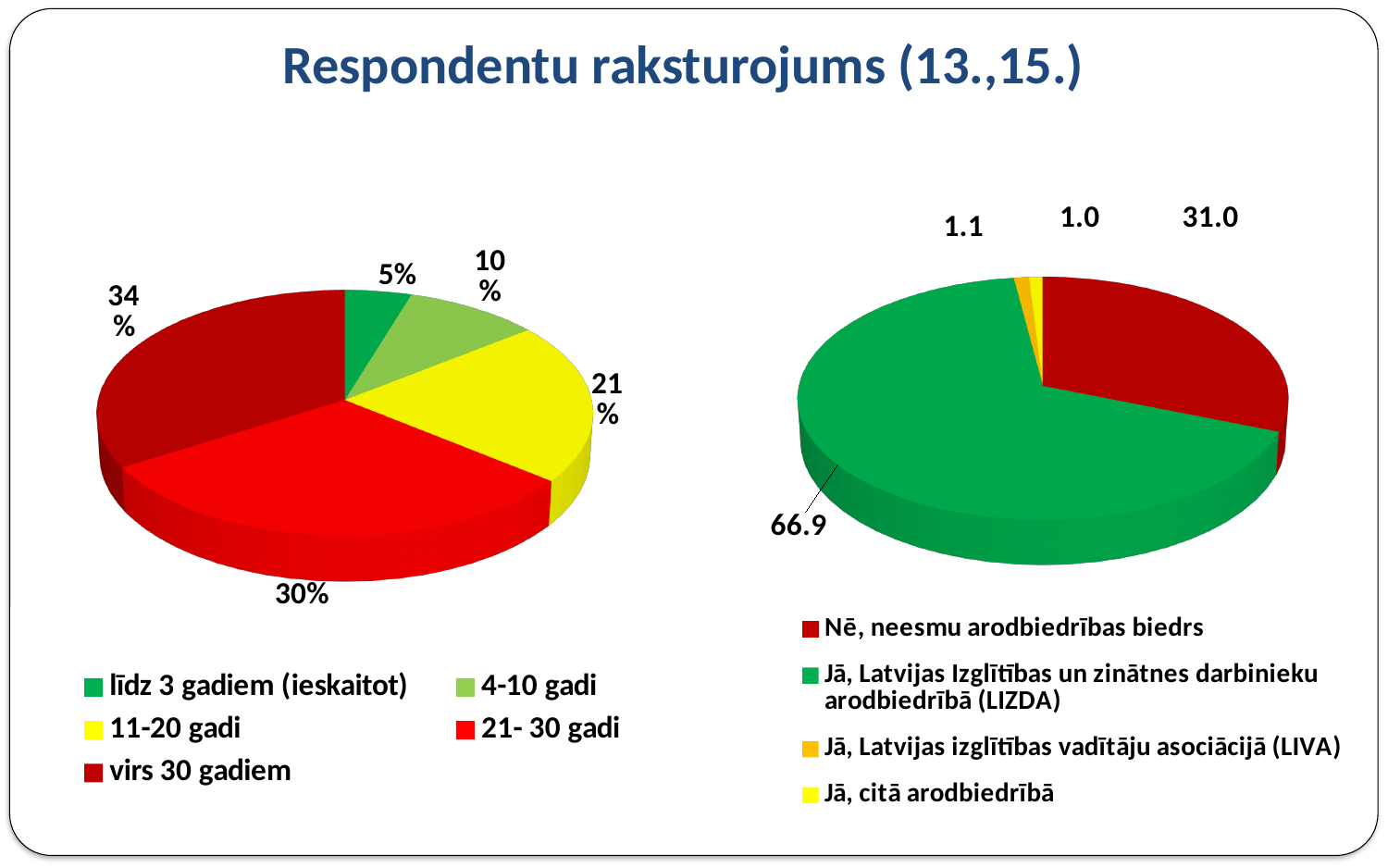
On the right pie chart, how many categories does the legend list? 4 On the left pie chart, which category has the largest share? virs 30 gadiem What type of chart is used on the left side of the slide? Pie chart On the left pie chart, what percentage of respondents have 21-30 gadi of experience? 30% On the left pie chart, which category has the smallest share? līdz 3 gadiem (ieskaitot) On the left pie chart, what is the value for 'līdz 3 gadiem (ieskaitot)'? 5% On the right pie chart, what is the value for 'Nē, neesmu arodbiedrības biedrs'? 31.0 On the left pie chart, what is the difference between the shares for '11-20 gadi' and '4-10 gadi'? 11% On the left pie chart, how many categories are shown? 5 On the right pie chart, what is the value for 'Jā, Latvijas Izglītības un zinātnes darbinieku arodbiedrībā (LIZDA)'? 66.9 On the left pie chart, what is the share for 'virs 30 gadiem'? 34% On the right pie chart, which category has the largest share? Jā, Latvijas Izglītības un zinātnes darbinieku arodbiedrībā (LIZDA)